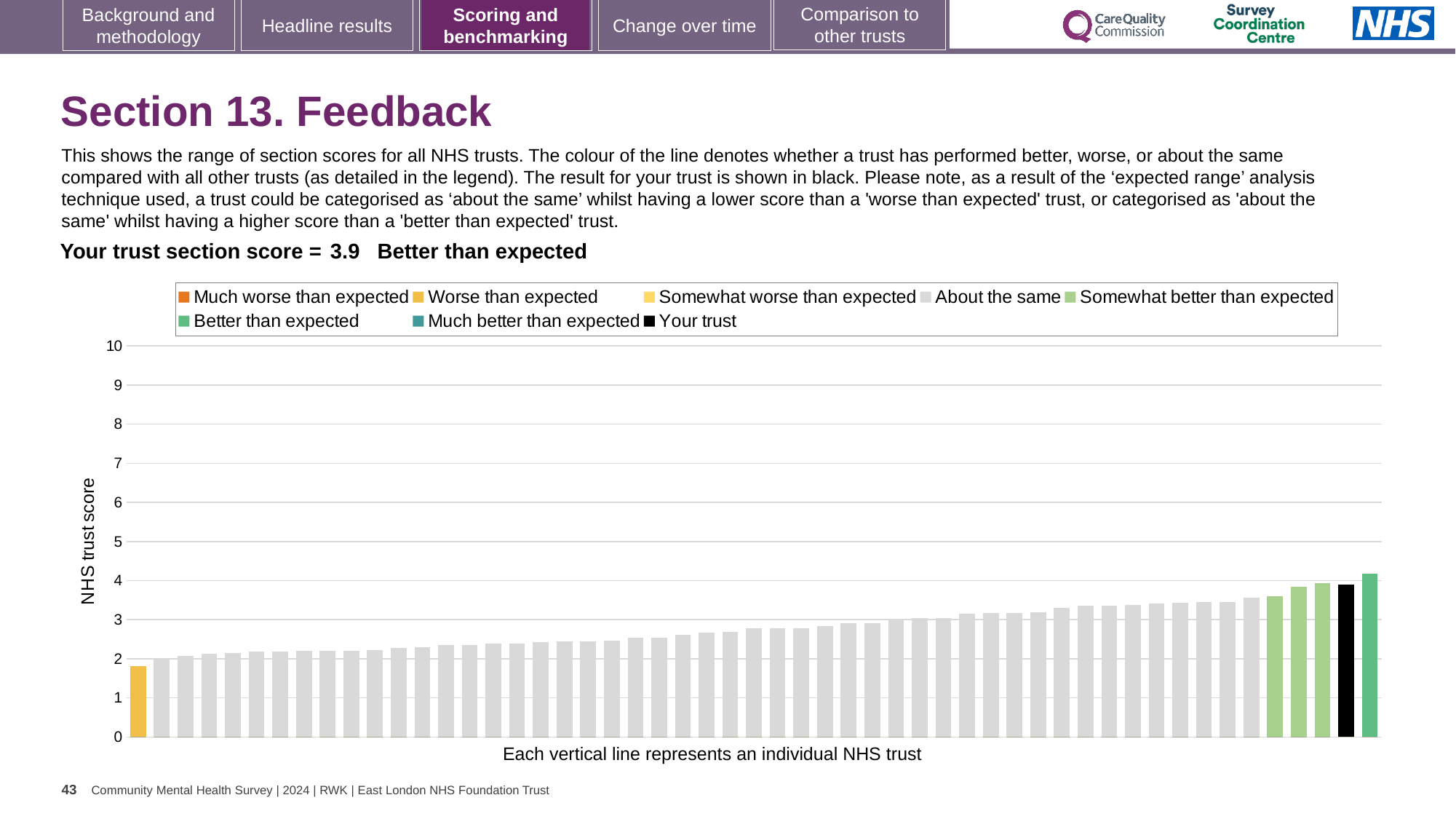
What colour is the bar representing your trust? Black What is the highest value shown on the vertical axis? 10 What is the label on the vertical axis of the chart? NHS trust score Do the bar values rise or fall from left to right along the x axis? rise Which benchmarking category is your trust's section score placed in? Better than expected Is the value of the black 'Your trust' bar greater or less than 3? greater Which is larger: the value of the black 'Your trust' bar or the value of the leftmost bar? Your trust How many entries does the chart legend list? 8 Is the value of the leftmost bar greater or less than 2? less What is the section score for your trust shown on the slide? 3.9 What kind of chart is shown on the slide? Bar chart Is the black 'Your trust' bar the tallest bar in the chart? No